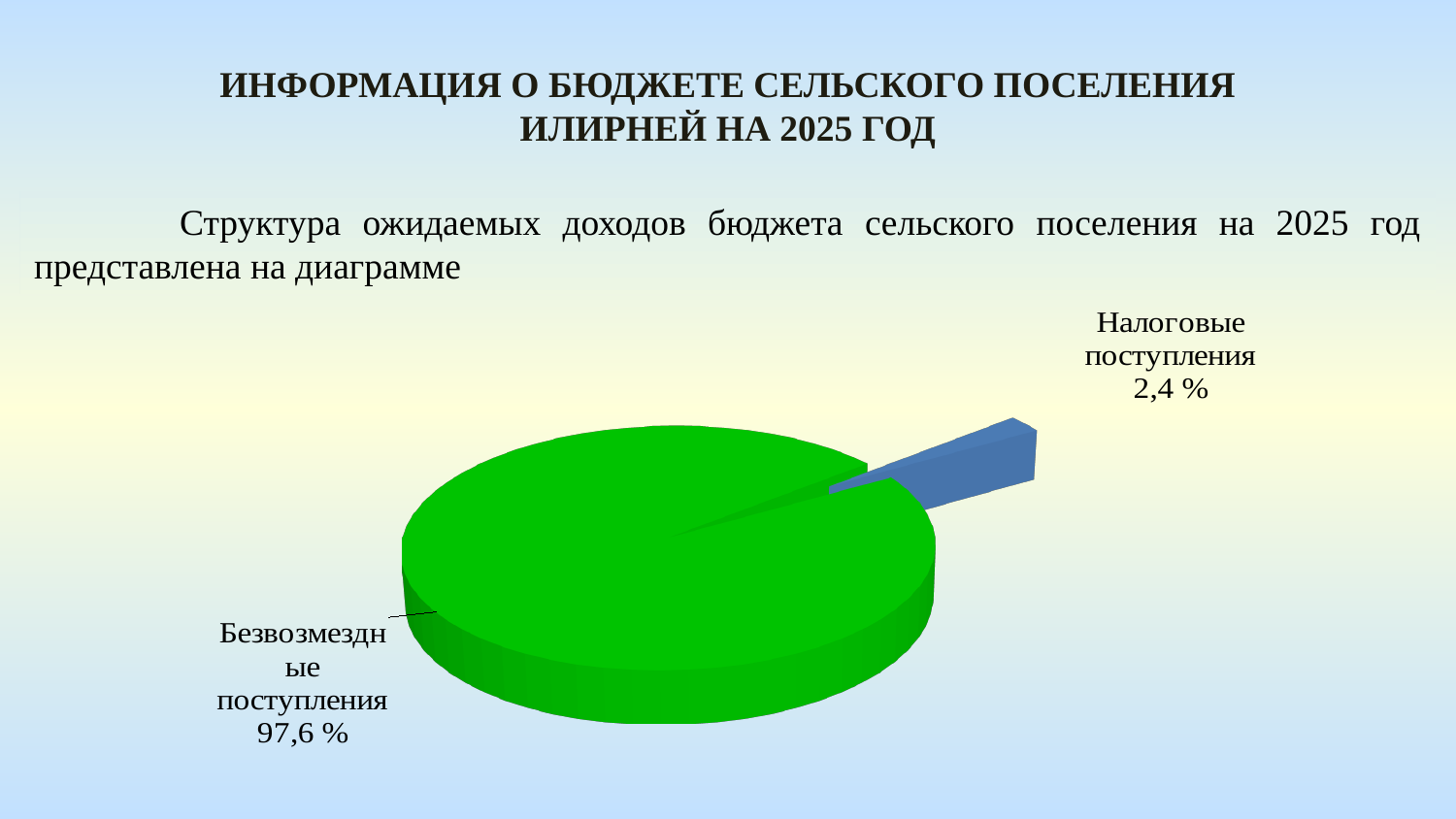
What share of the pie does "Налоговые поступления" represent? 2,4 % What is the difference in percentage points between "Безвозмездные поступления" and "Налоговые поступления"? 95,2 How many slices does the pie chart have? 2 What colour is the slice for "Безвозмездные поступления"? green Which category has the smallest share of the pie? Налоговые поступления What share of the pie does "Безвозмездные поступления" represent? 97,6 % What colour is the slice for "Налоговые поступления"? blue What kind of chart is shown on the slide? pie chart Which category has the largest share of the pie? Безвозмездные поступления Which is larger: the share for "Налоговые поступления" or the share for "Безвозмездные поступления"? Безвозмездные поступления